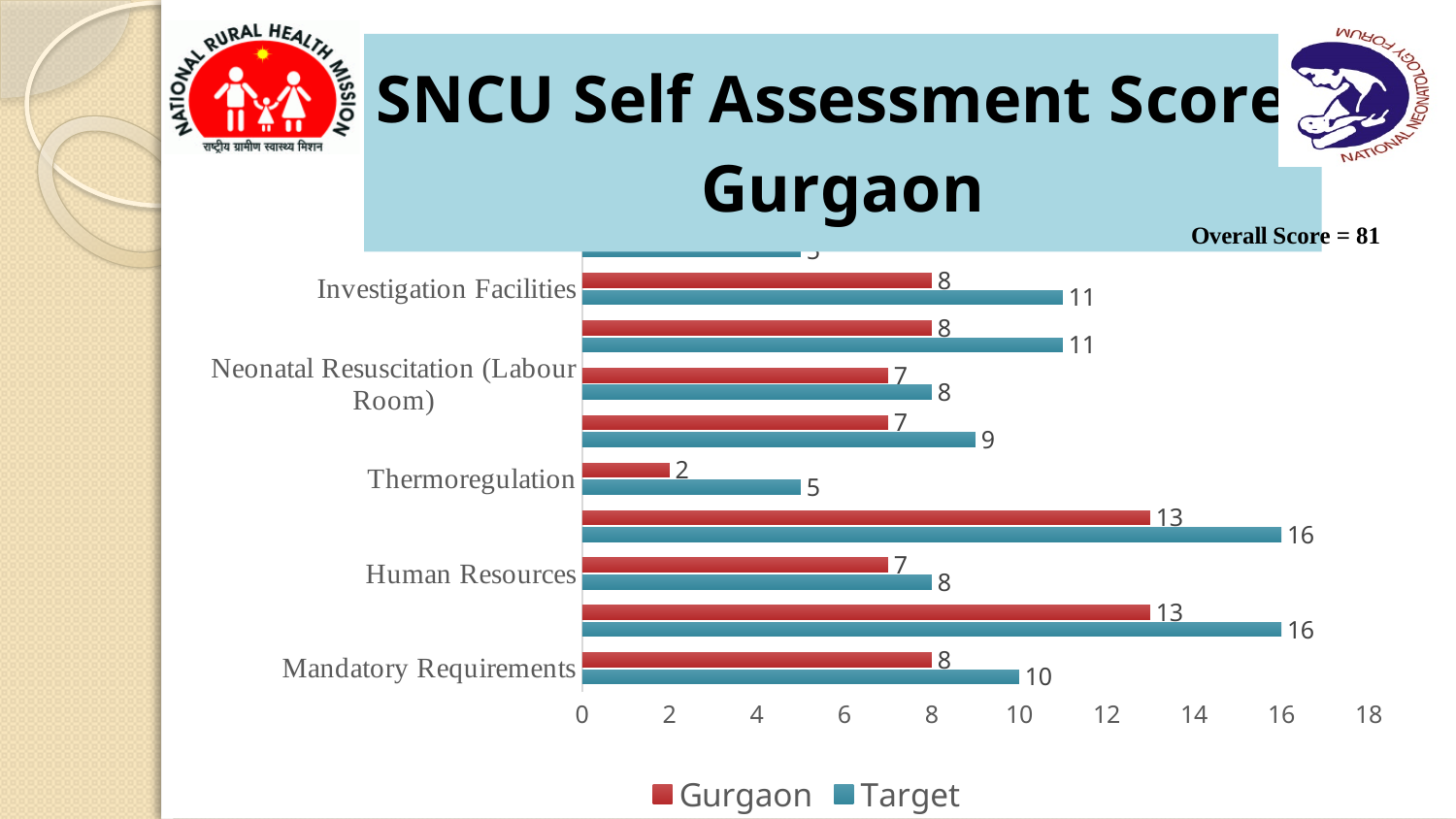
What is the difference between the Target and Gurgaon values for Thermoregulation? 3 What overall score is stated on the slide? 81 What is the Gurgaon value for Neonatal Resuscitation (Labour Room)? 7 What is the Target value for Thermoregulation? 5 How many series does the legend list? 2 What is the Target value for Investigation Facilities? 11 What is the Gurgaon value for Thermoregulation? 2 What is the difference between the Target and Gurgaon values for Investigation Facilities? 3 What is the Target value for Human Resources? 8 What kind of chart is shown on the slide? Bar chart What is the Gurgaon value for Mandatory Requirements? 8 Which is larger for Mandatory Requirements, the Gurgaon value or the Target value? Target